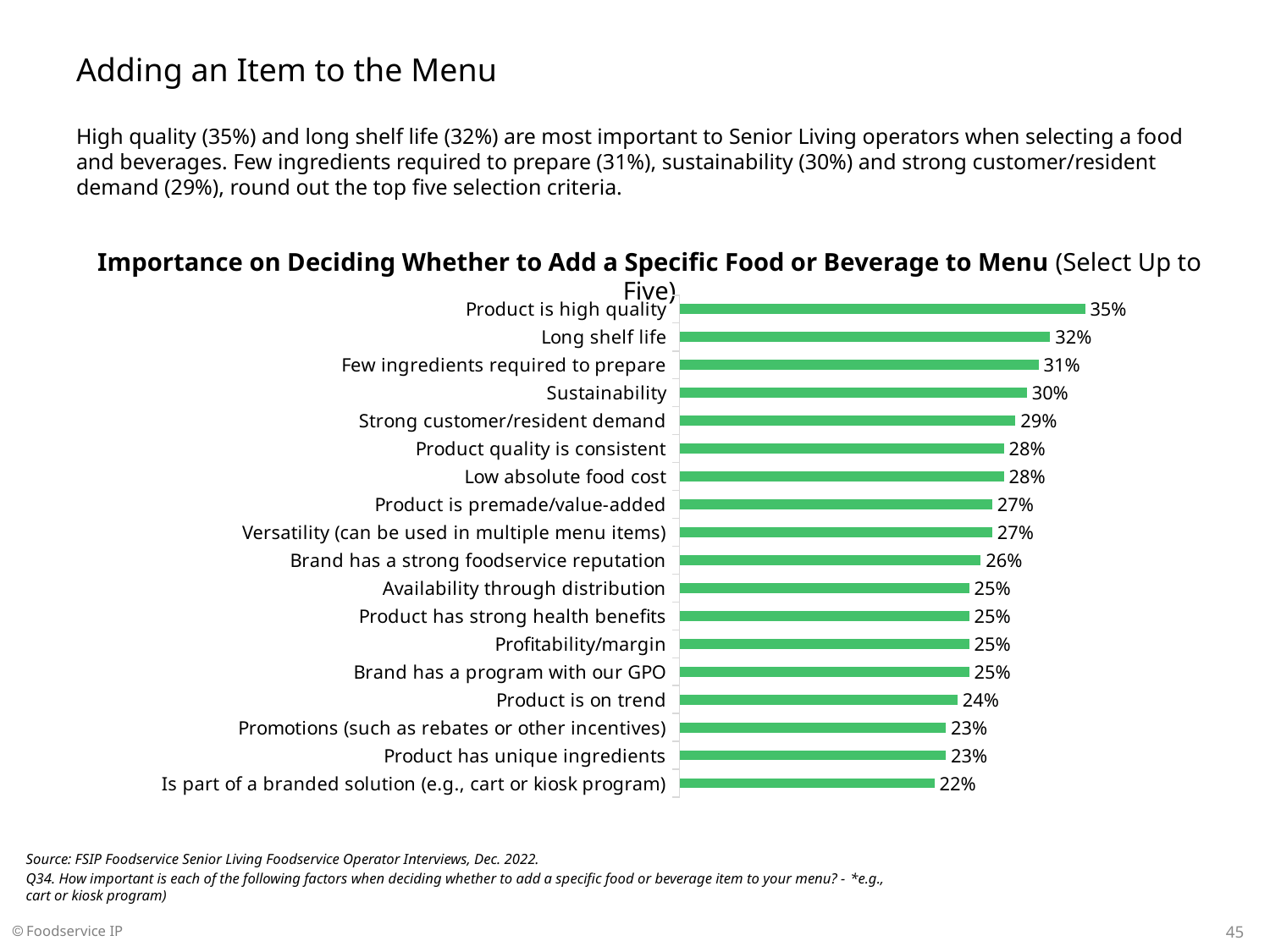
What is the difference between the values for "Product is high quality" and "Long shelf life"? 3% What is the difference between the values for "Strong customer/resident demand" and "Product is on trend"? 5% What is the value for "Brand has a program with our GPO"? 25% How many categories are shown in the chart? 18 What is the bold part of the chart title? Importance on Deciding Whether to Add a Specific Food or Beverage to Menu What is the value for "Sustainability"? 30% What is the value for "Is part of a branded solution (e.g., cart or kiosk program)"? 22% Which category has the highest value? Product is high quality Which is larger, the value for "Few ingredients required to prepare" or the value for "Brand has a strong foodservice reputation"? Few ingredients required to prepare What is the value for "Product is high quality"? 35% What kind of chart is shown on the slide? Bar chart Which category has the lowest value? Is part of a branded solution (e.g., cart or kiosk program)